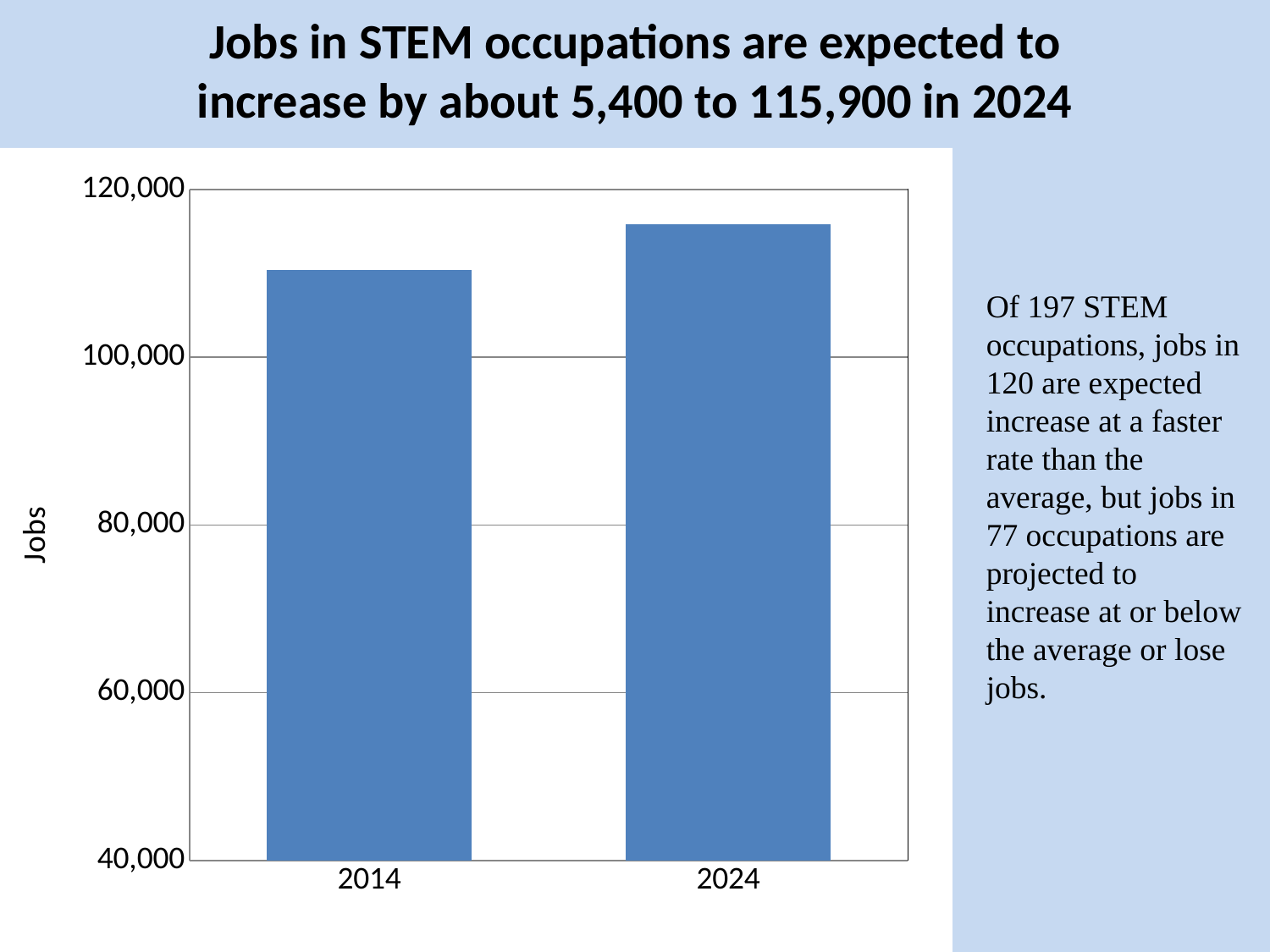
What is the lowest value shown on the vertical axis? 40,000 Is the value for 2014 greater or less than 100,000? greater Which category has the lowest value in the chart? 2014 Which category has the highest value in the chart? 2024 Is the value for 2024 greater or less than 120,000? less What kind of chart is shown on the slide? bar chart Is the value for 2014 greater or less than 120,000? less Do the values rise or fall from 2014 to 2024? rise What is the label on the vertical axis of the chart? Jobs How many bars (categories) does the chart show? 2 Which year has the higher number of jobs, 2014 or 2024? 2024